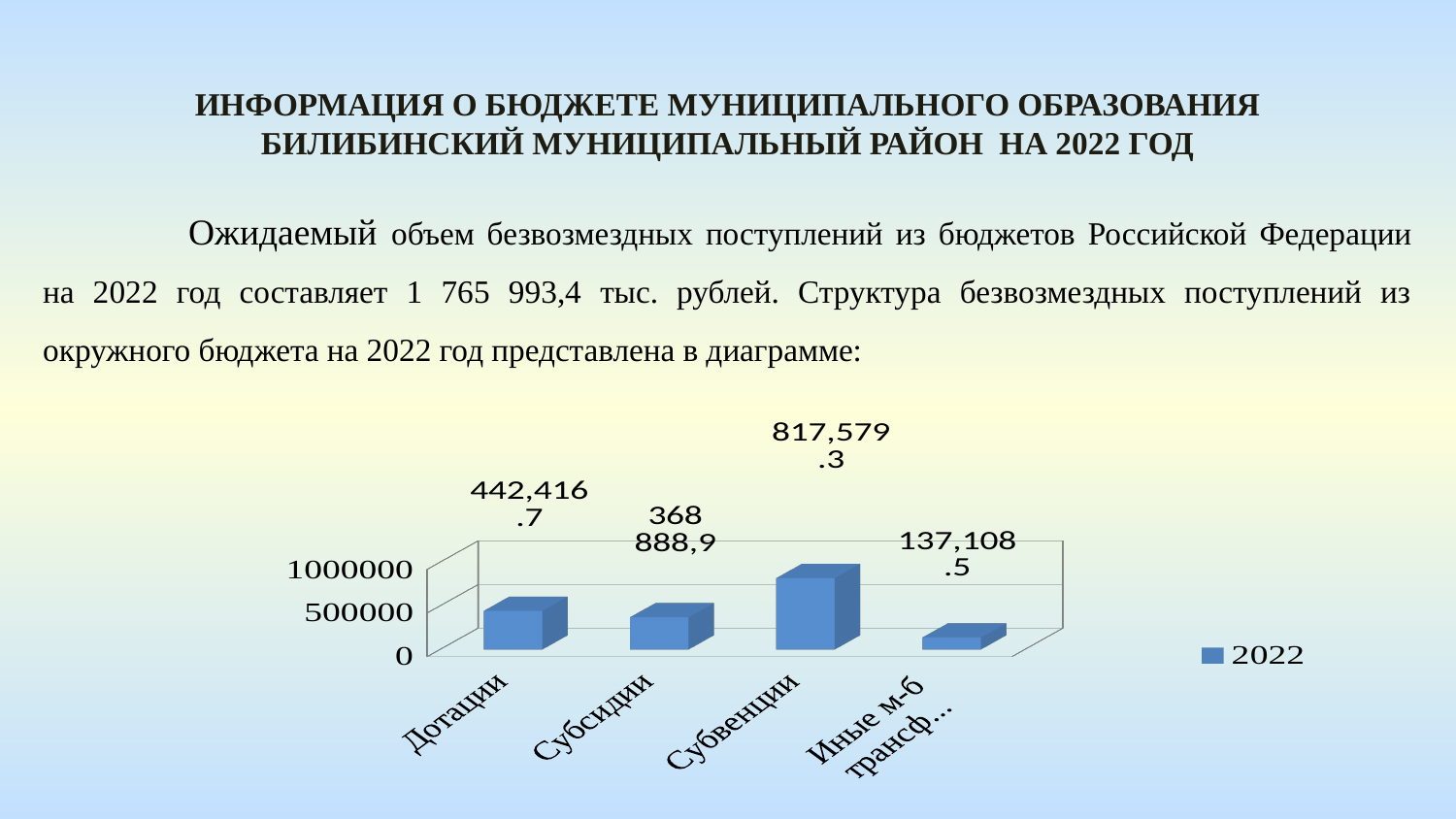
Is the value for Дотации greater or less than 500000? less Is the value for Субвенции greater or less than 500000? greater Which category has the lowest value? Иные м-б трансф... What is the value for Дотации? 442,416.7 What is the value for Субсидии? 368 888,9 How many series does the legend list? 1 Which is larger, the value for Дотации or the value for Субсидии? Дотации How many categories are shown on the chart? 4 What kind of chart is shown on the slide? bar chart What is the value for Субвенции? 817,579.3 Which category has the highest value? Субвенции What is the difference between the values for Субвенции and Дотации? 375,162.6